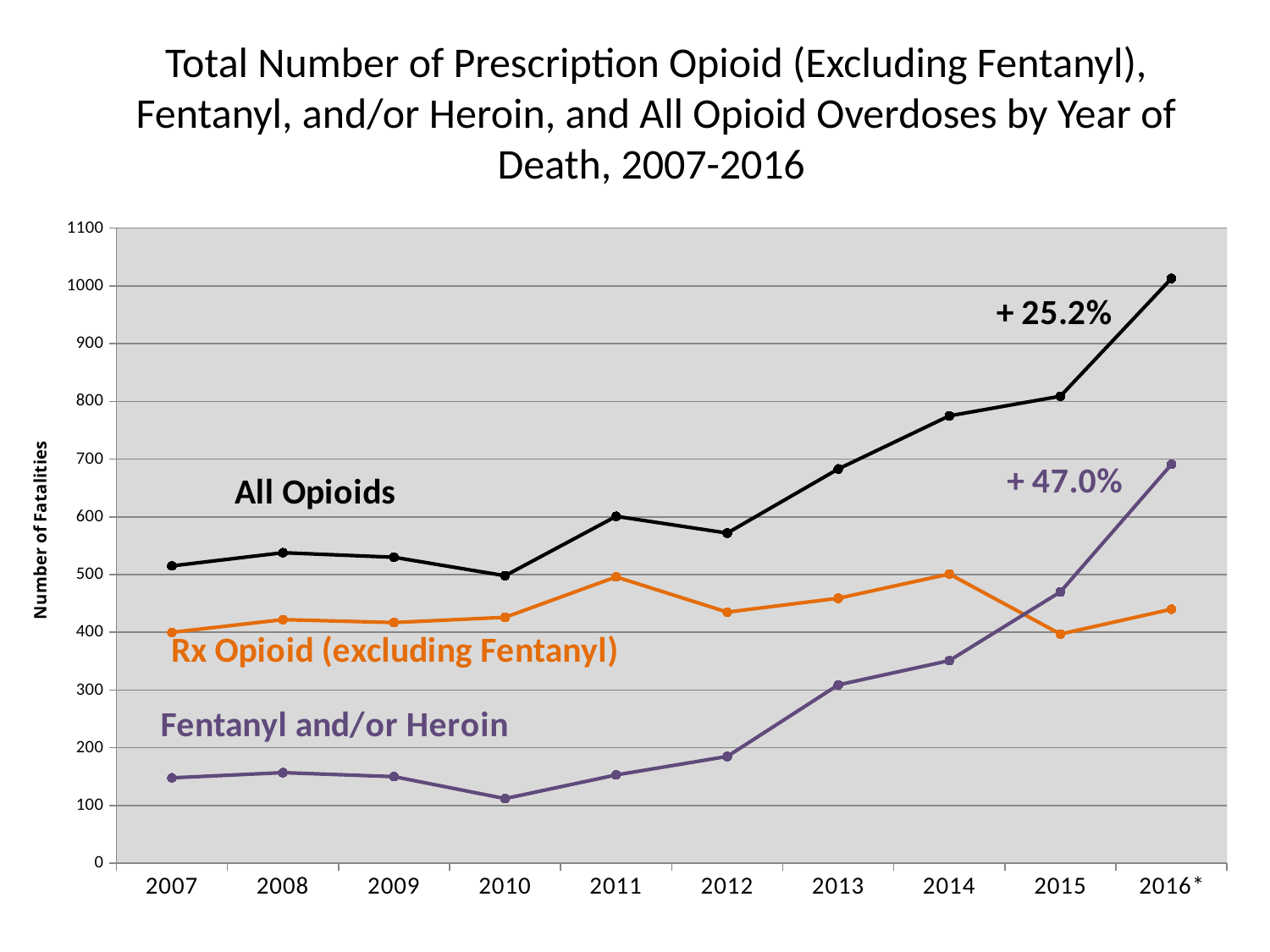
How many years are plotted along the x axis? 10 What percentage change is annotated next to the All Opioids line? + 25.2% How many data series are plotted on the chart? 3 Is the All Opioids value for 2016* greater or less than 900? greater What kind of chart is shown on the slide? line chart In which year is the Fentanyl and/or Heroin series at its lowest? 2010 In 2016*, which is larger: Fentanyl and/or Heroin or Rx Opioid (excluding Fentanyl)? Fentanyl and/or Heroin Does the Fentanyl and/or Heroin series rise or fall from 2012 to 2016*? rise In which year is the All Opioids series at its highest? 2016* What is the label on the y axis? Number of Fatalities Is the Fentanyl and/or Heroin value for 2010 greater or less than 200? less Is the Rx Opioid (excluding Fentanyl) value for 2014 greater or less than 400? greater